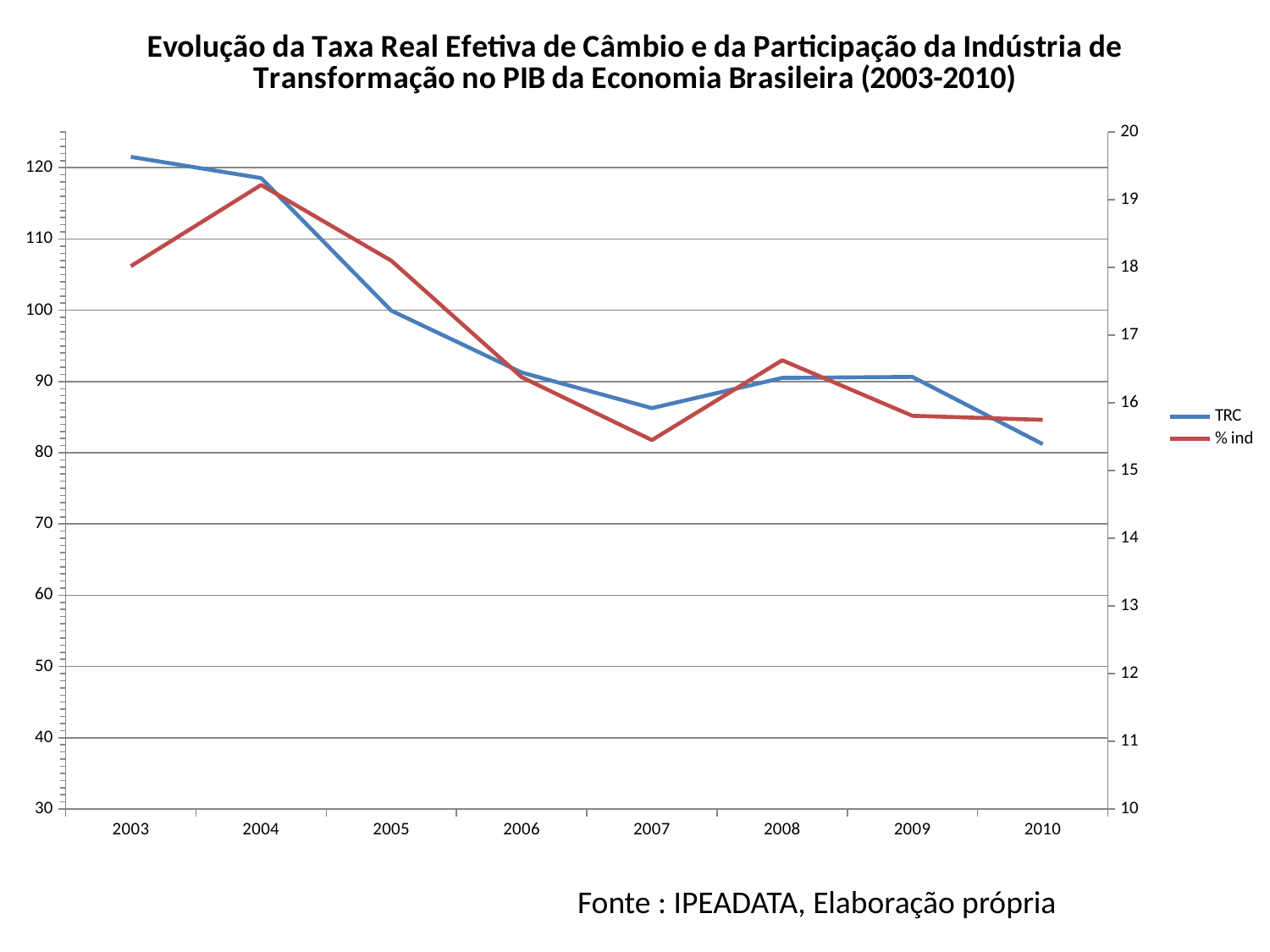
In which year is the TRC series at its lowest? 2010 Is the % ind value for 2007 greater or less than 16? less How many years are plotted along the x axis? 8 Which series is drawn in red according to the legend? % ind Is the TRC value for 2007 greater or less than 90? less In which year is the TRC series at its highest? 2003 What kind of chart is shown on the slide? line chart In which year is the % ind series at its highest? 2004 Does the TRC series overall rise or fall from 2003 to 2010? fall In which year is the % ind series at its lowest? 2007 How many series does the legend list? 2 Is the TRC value for 2003 greater or less than 120? greater